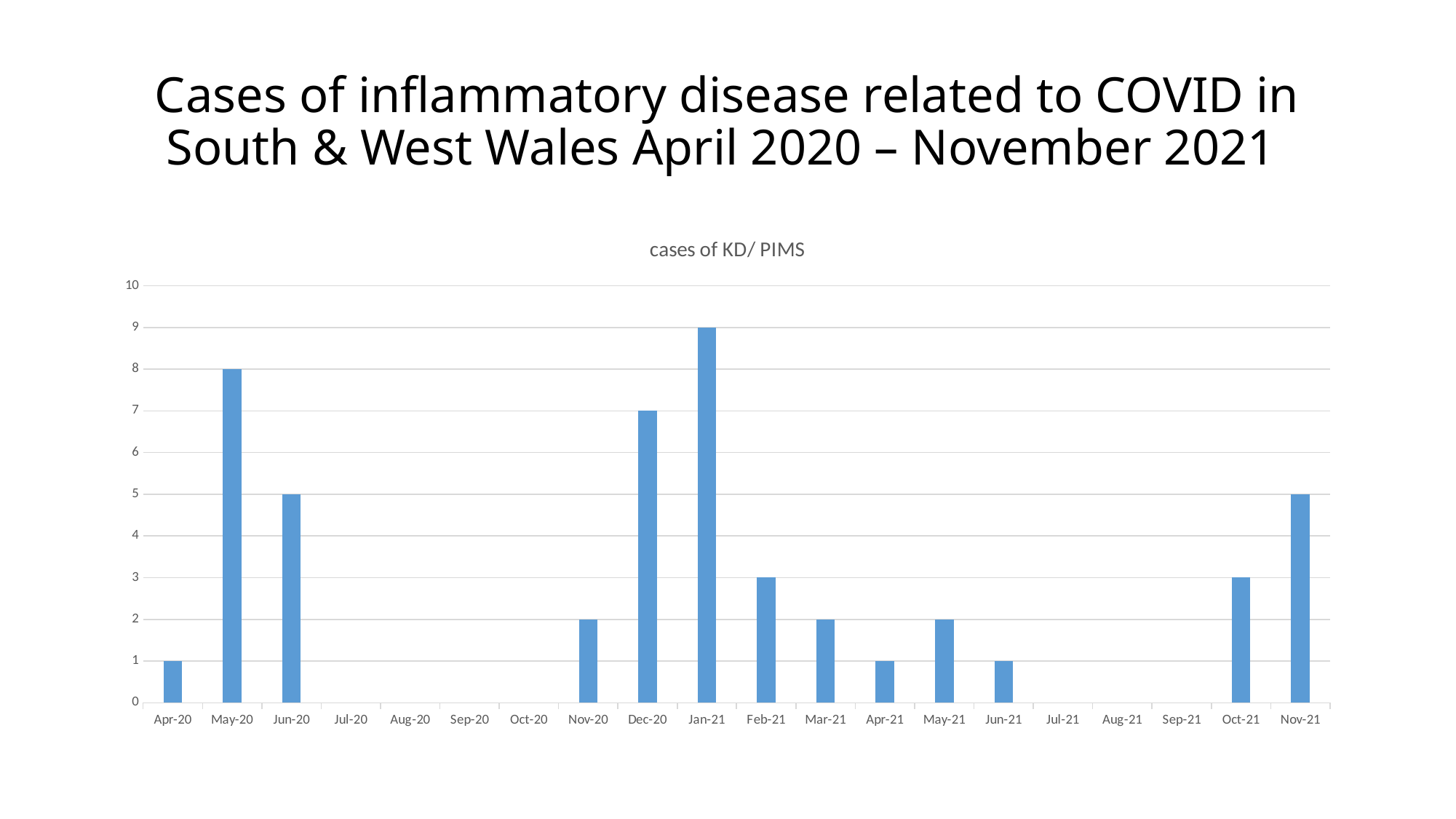
What is the value for Jan-21? 9 Which is larger, the value for May-20 or the value for Jun-20? May-20 What is the value for Nov-21? 5 What is the value for May-20? 8 Which month has the highest number of cases? Jan-21 Do the values rise or fall from Jan-21 to Apr-21? Fall What is the difference between the values for Jan-21 and Dec-20? 2 What is the value for Feb-21? 3 Is the value for Dec-20 greater or less than 5? greater What kind of chart is shown? Bar chart How many months are shown on the x axis? 20 What is the title of the chart? cases of KD/ PIMS